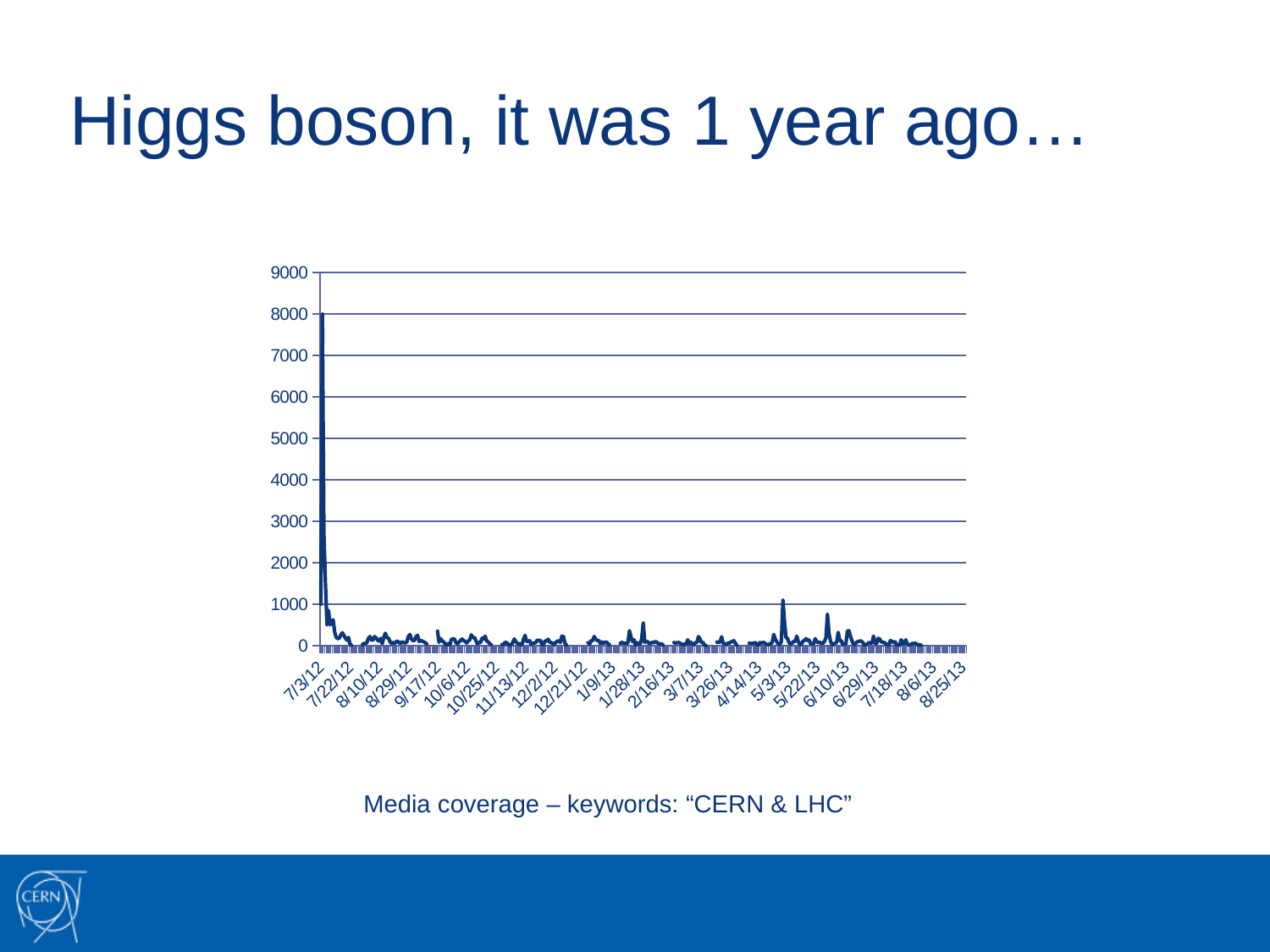
Is the peak value of the line at 7/3/12 greater or less than 7000? greater Is the value of the line around 5/3/13 greater or less than 2000? less Overall, do the values rise or fall along the x axis from 7/3/12 to 8/25/13? fall What is the highest value shown on the y axis? 9000 Is the value of the line around 10/25/12 greater or less than 1000? less How many data series are plotted on the chart? 1 What kind of chart is shown on the slide? line chart How many date labels are shown on the x axis? 23 Is the value of the line at 7/3/12 larger or smaller than the value at 5/3/13? larger What is the first date label on the x axis? 7/3/12